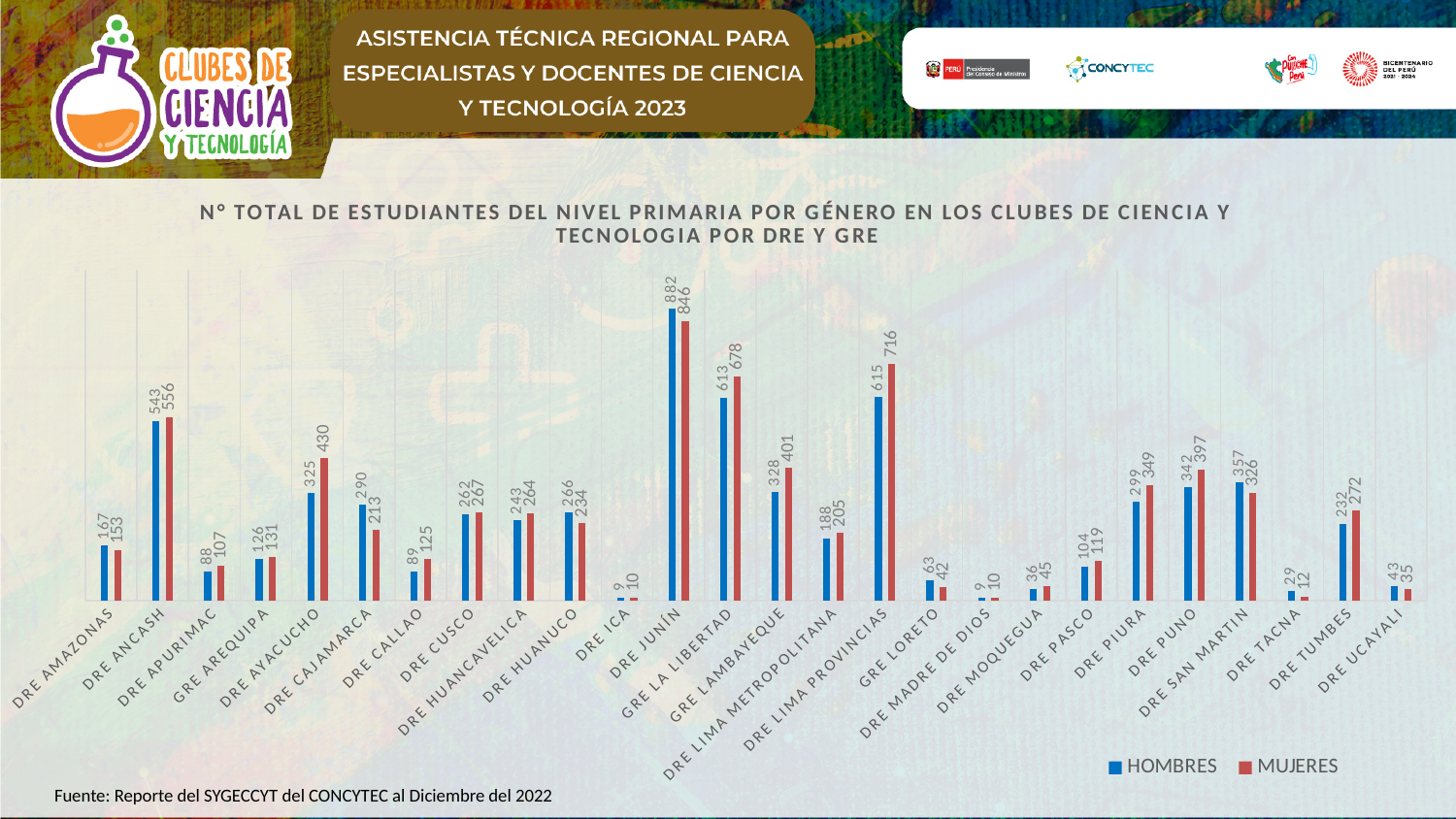
What kind of chart is shown on the slide? Bar chart What is the HOMBRES value for DRE JUNÍN? 882 How many series does the legend list? 2 What is the MUJERES value for DRE LIMA PROVINCIAS? 716 Which DRE/GRE has the highest HOMBRES value? DRE JUNÍN What is the MUJERES value for DRE AYACUCHO? 430 Which DRE/GRE has the highest MUJERES value? DRE JUNÍN What is the difference between the MUJERES and HOMBRES values for DRE LIMA PROVINCIAS? 101 What is the difference between the HOMBRES and MUJERES values for DRE JUNÍN? 36 Which is larger for DRE CAJAMARCA, the HOMBRES value or the MUJERES value? HOMBRES How many DRE/GRE categories are shown on the x axis? 26 What is the HOMBRES value for GRE LA LIBERTAD? 613